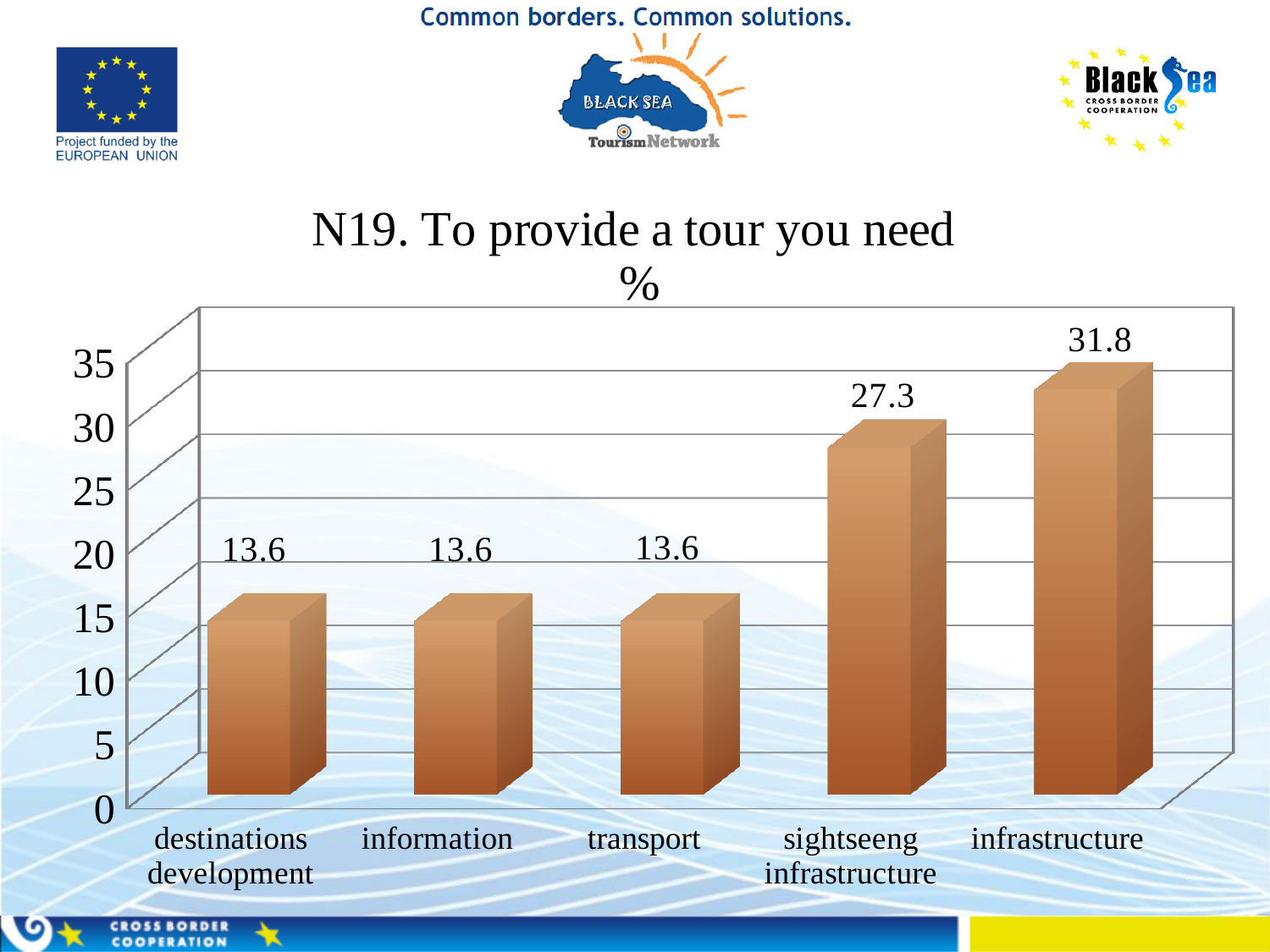
Is the value for infrastructure greater or less than 30? greater How many categories are shown on the x axis? 5 What kind of chart is shown on the slide? bar chart Is the value for information greater or less than 15? less What is the difference between the values for infrastructure and sightseeng infrastructure? 4.5 What is the difference between the values for sightseeng infrastructure and information? 13.7 Which is larger, the value for sightseeng infrastructure or the value for destinations development? sightseeng infrastructure What is the value for sightseeng infrastructure? 27.3 What is the value for infrastructure? 31.8 Which category has the highest value? infrastructure What is the value for transport? 13.6 What is the title of the chart? N19. To provide a tour you need %